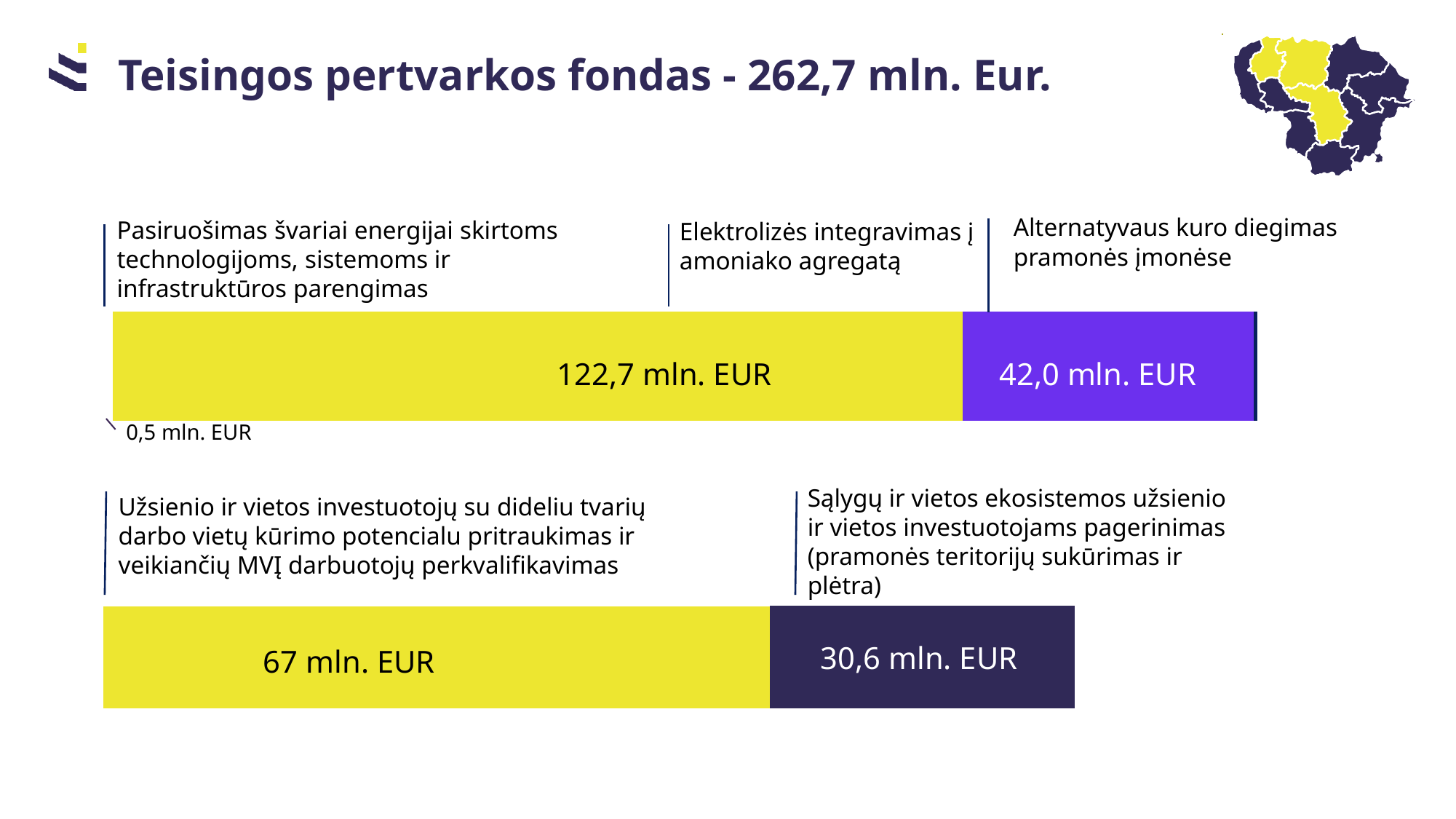
In the top bar, what is the value for 'Alternatyvaus kuro diegimas pramonės įmonėse'? 42,0 mln. EUR In the bottom bar, what is the difference between the 67 mln. EUR segment and the 30,6 mln. EUR segment? 36,4 mln. EUR In the bottom bar, what is the value for 'Užsienio ir vietos investuotojų su dideliu tvarių darbo vietų kūrimo potencialu pritraukimas ir veikiančių MVĮ darbuotojų perkvalifikavimas'? 67 mln. EUR What is the total of the bottom stacked bar? 97,6 mln. EUR In the bottom bar, what is the value for 'Sąlygų ir vietos ekosistemos užsienio ir vietos investuotojams pagerinimas'? 30,6 mln. EUR In the top bar, what is the value for 'Elektrolizės integravimas į amoniako agregatą'? 122,7 mln. EUR What is the title of the slide? Teisingos pertvarkos fondas - 262,7 mln. Eur. In the top bar, which segment has the smallest value? Pasiruošimas švariai energijai skirtoms technologijoms, sistemoms ir infrastruktūros parengimas In the bottom bar, which is larger: the 'Užsienio ir vietos investuotojų...' segment or the 'Sąlygų ir vietos ekosistemos...' segment? Užsienio ir vietos investuotojų su dideliu tvarių darbo vietų kūrimo potencialu pritraukimas ir veikiančių MVĮ darbuotojų perkvalifikavimas In the top bar, what is the value for 'Pasiruošimas švariai energijai skirtoms technologijoms, sistemoms ir infrastruktūros parengimas'? 0,5 mln. EUR In the top bar, which segment has the largest value? Elektrolizės integravimas į amoniako agregatą In the top bar, what is the difference between the 'Elektrolizės integravimas į amoniako agregatą' segment and the 'Alternatyvaus kuro diegimas pramonės įmonėse' segment? 80,7 mln. EUR